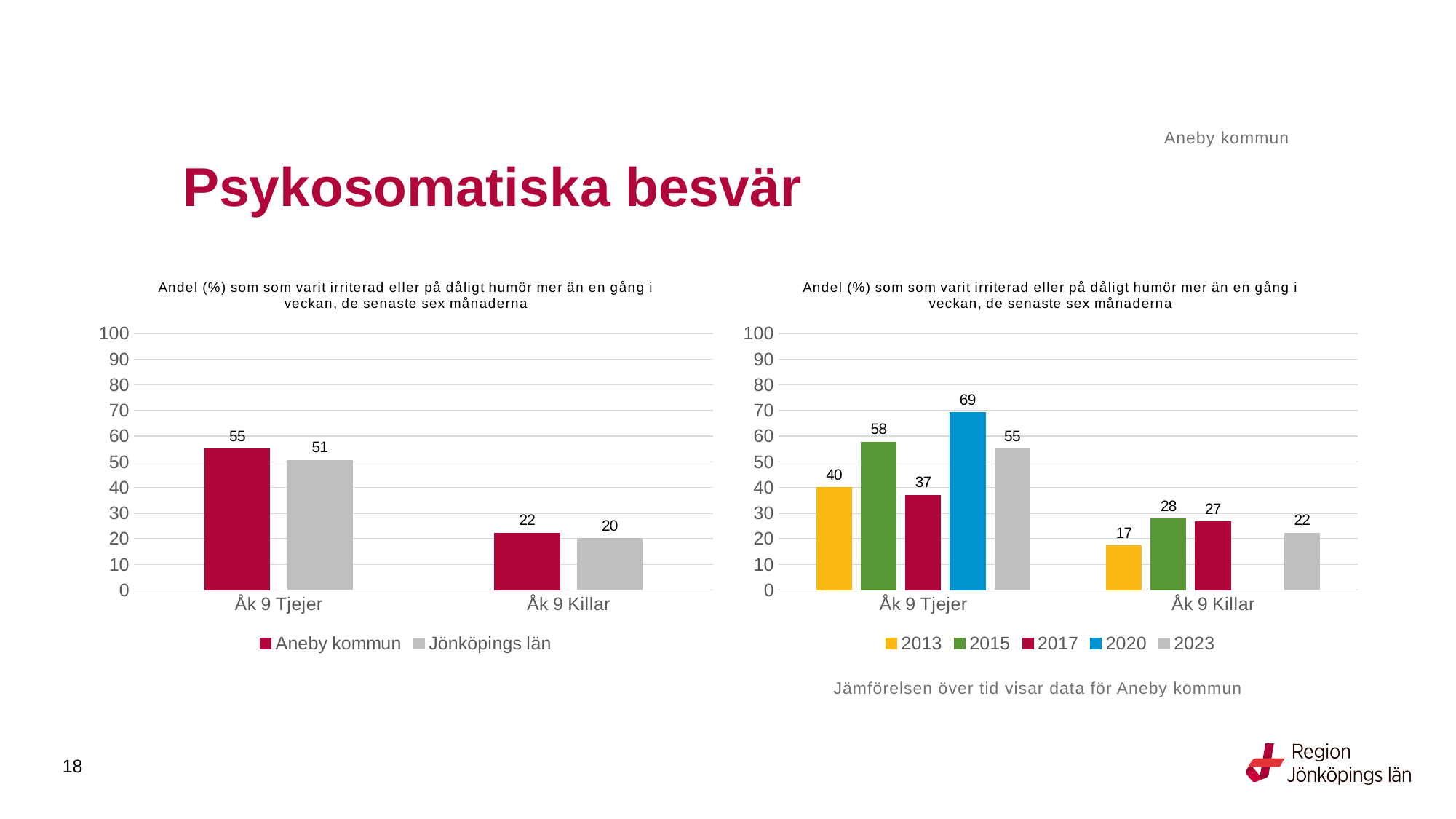
In the right chart, what is the value for 2020 for Åk 9 Tjejer? 69 In the left chart, how many series does the legend list? 2 In the right chart, what is the difference between the 2020 and 2017 values for Åk 9 Tjejer? 32 In the right chart, what is the value for 2013 for Åk 9 Killar? 17 In the right chart, how many series does the legend list? 5 In the left chart, what is the value for Jönköpings län for Åk 9 Killar? 20 In the right chart, which is larger for Åk 9 Killar: the 2015 value or the 2023 value? 2015 In the right chart, which year has the highest value for Åk 9 Tjejer? 2020 In the left chart, what is the value for Aneby kommun for Åk 9 Tjejer? 55 What kind of chart is the left chart? Bar chart In the right chart, which year has the lowest value for Åk 9 Killar? 2013 In the left chart, what is the difference between Aneby kommun and Jönköpings län for Åk 9 Tjejer? 4